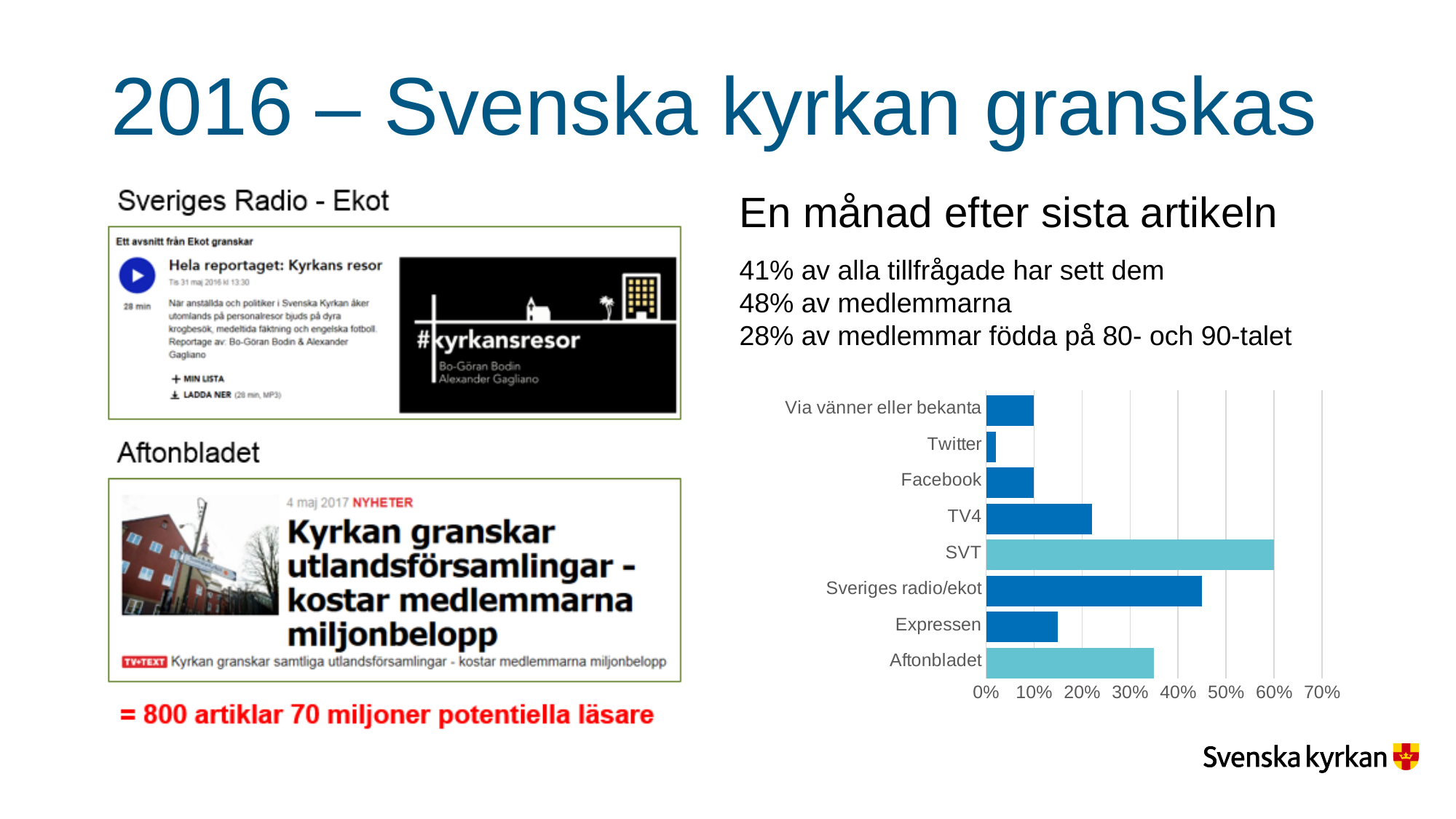
Is the value for SVT greater or less than 50%? greater How many categories are plotted in the bar chart? 8 What is the highest tick label shown on the horizontal axis of the bar chart? 70% Which category has the highest value in the bar chart? SVT Which has a larger value, Aftonbladet or Sveriges radio/ekot? Sveriges radio/ekot What kind of chart is shown on the slide? bar chart Which category has the lowest value in the bar chart? Twitter Which has a larger value, TV4 or Expressen? TV4 Is the value for TV4 greater or less than 30%? less Is the value for Twitter greater or less than 10%? less